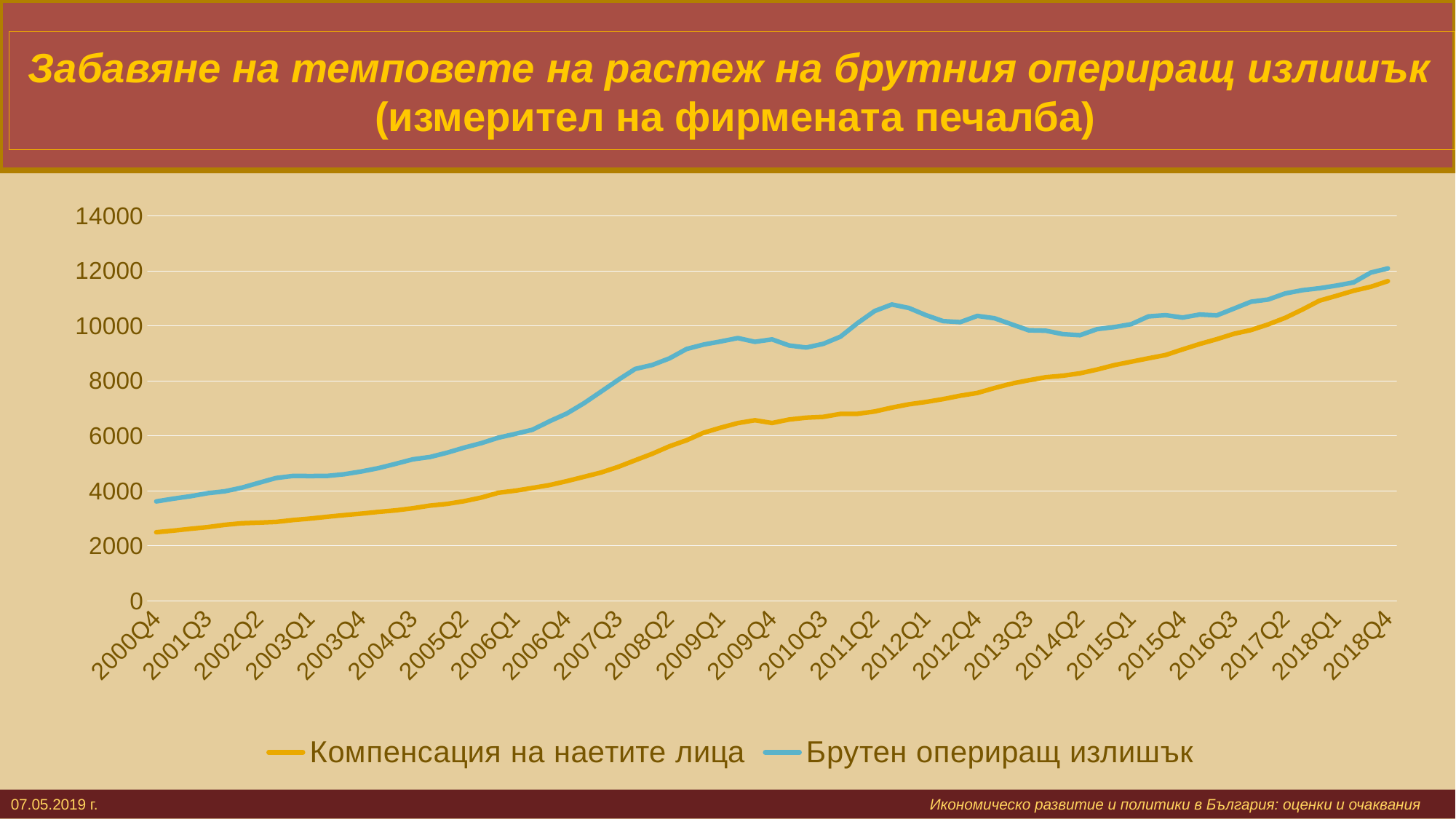
Which series is shown in blue? Брутен опериращ излишък Is the value of Брутен опериращ излишък at 2011Q2 greater or less than 10000? greater Is the value of Компенсация на наетите лица at 2000Q4 greater or less than 2000? greater Is the value of Компенсация на наетите лица at 2018Q4 greater or less than 12000? less How many series does the legend list? 2 What kind of chart is shown on the slide? line chart Does the value of Компенсация на наетите лица rise or fall from 2000Q4 to 2018Q4? rise At which x-axis point does Брутен опериращ излишък reach its lowest value? 2000Q4 At 2018Q4, which series has the larger value, Компенсация на наетите лица or Брутен опериращ излишък? Брутен опериращ излишък Which series is shown in orange? Компенсация на наетите лица